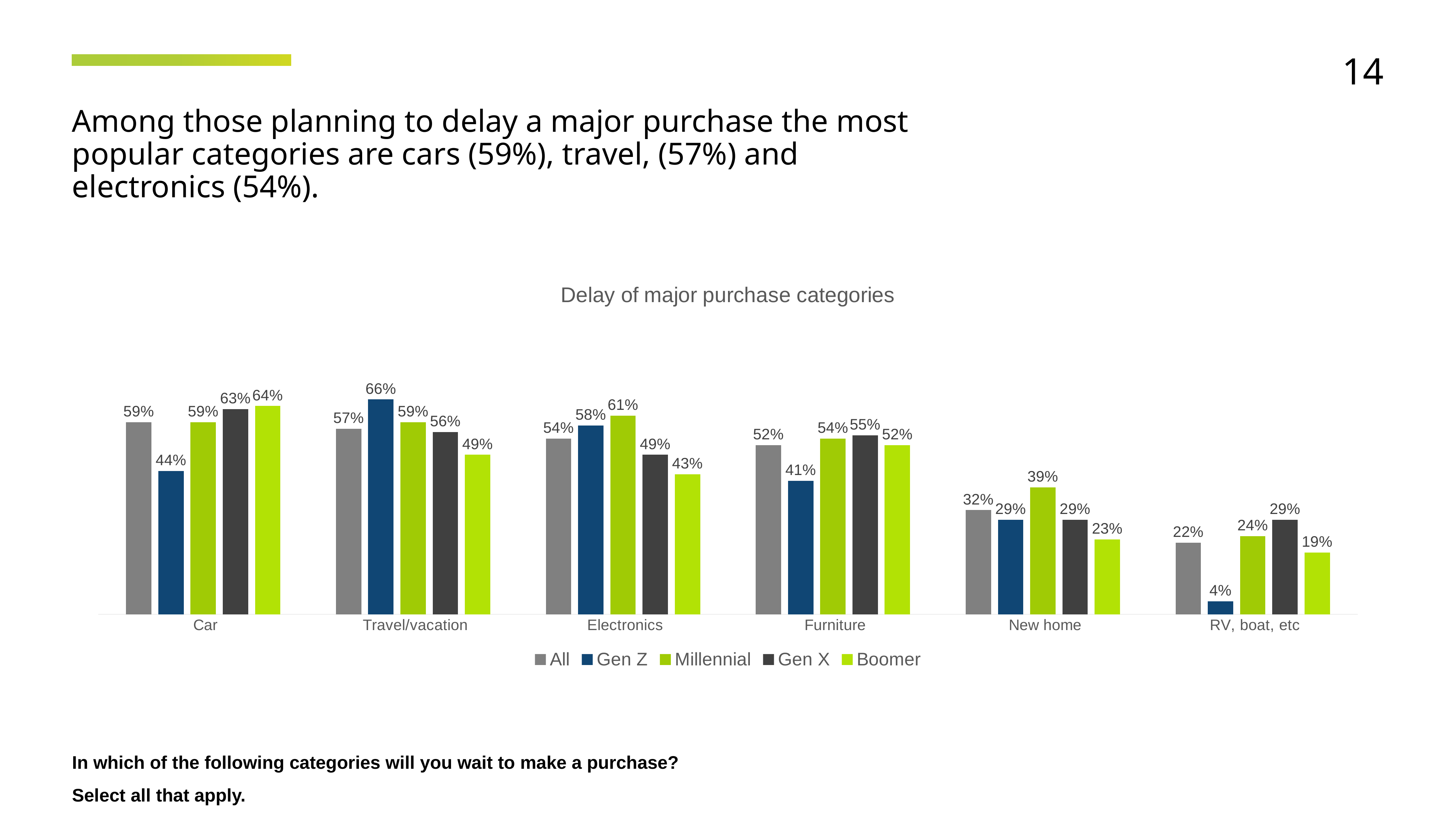
What is the value for Gen Z in the Car category? 44% Which category has the lowest value for Gen Z? RV, boat, etc What is the value for Boomer in the Travel/vacation category? 49% How many series does the legend list? 5 What is the difference between the Gen Z and Boomer values in the Travel/vacation category? 17% Which category has the highest value for the All series? Car What is the difference between the Gen X and Gen Z values in the RV, boat, etc category? 25% How many categories are shown on the x axis? 6 What kind of chart is shown on the slide? Bar chart Which is larger in the Electronics category: the Millennial value or the Gen X value? Millennial What is the title of the chart? Delay of major purchase categories What is the value for Millennial in the New home category? 39%